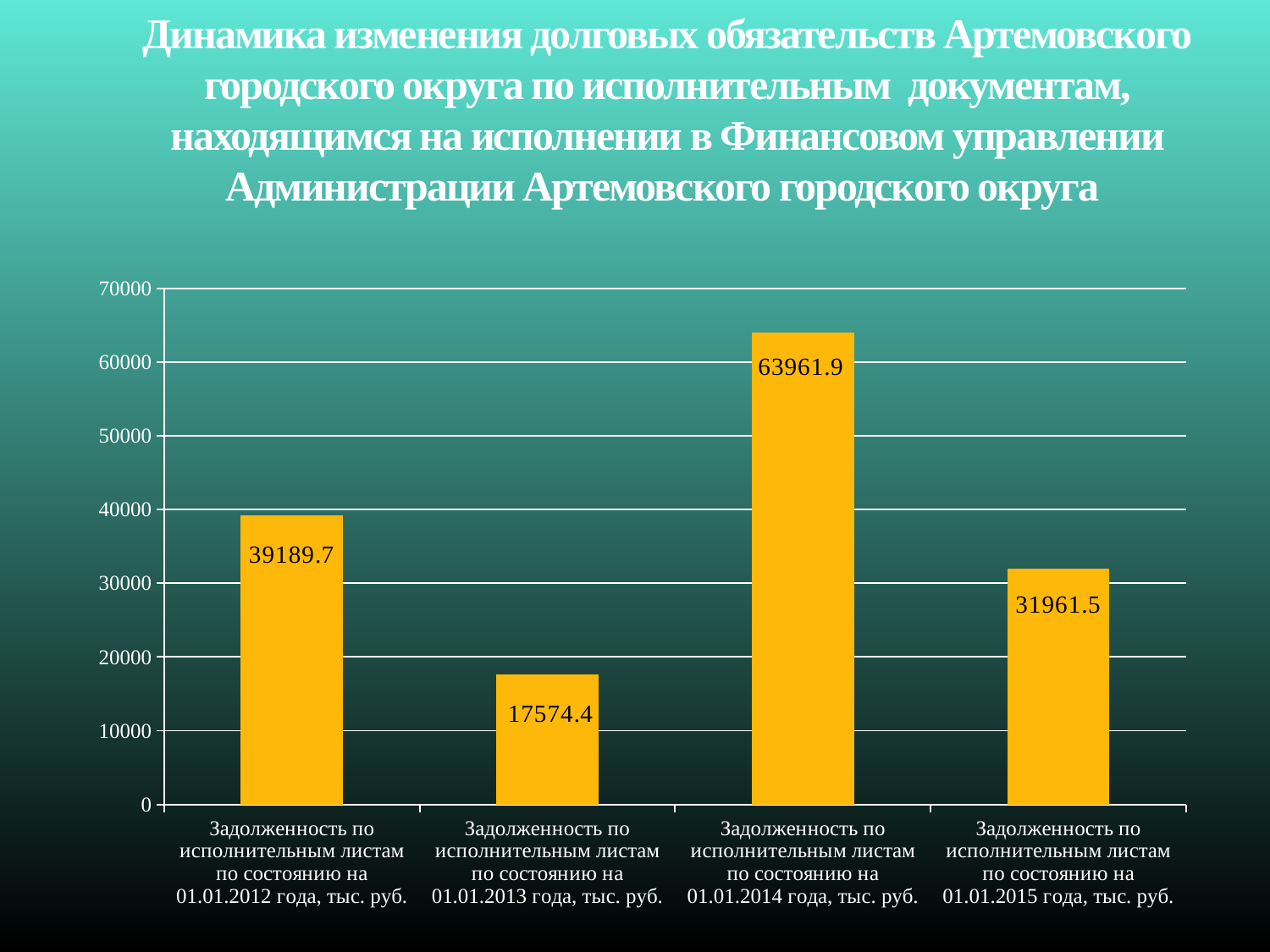
What is the value of the debt on enforcement documents as of 01.01.2015? 31961.5 Which is larger: the debt as of 01.01.2012 or the debt as of 01.01.2015? 01.01.2012 What is the difference between the debt as of 01.01.2014 and the debt as of 01.01.2013? 46387.5 What is the value of the debt on enforcement documents as of 01.01.2012? 39189.7 As of which date is the debt on enforcement documents the highest? 01.01.2014 What is the value of the debt on enforcement documents as of 01.01.2014? 63961.9 What is the value of the debt on enforcement documents as of 01.01.2013? 17574.4 What is the difference between the debt as of 01.01.2012 and the debt as of 01.01.2015? 7228.2 What type of chart is shown on the slide? Bar chart What colour are the bars in the chart? Yellow (orange-yellow) How many bars are shown in the chart? 4 As of which date is the debt on enforcement documents the lowest? 01.01.2013